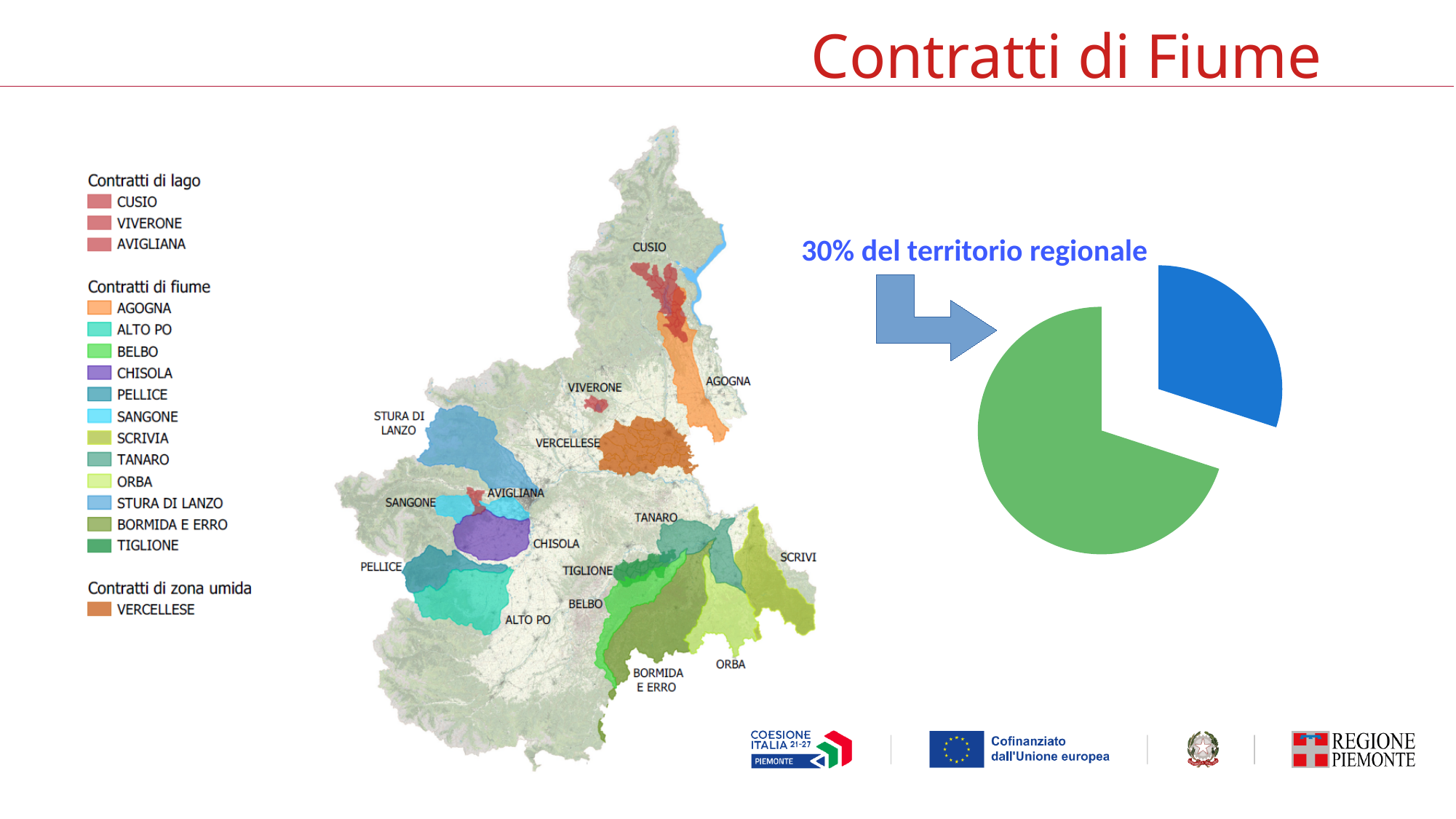
Which slice of the pie chart is pulled out (exploded) from the rest of the pie? the blue slice Is the blue slice of the pie chart greater or less than 50% of the pie? less Which colour slice is the largest in the pie chart? green What text does the arrow next to the pie chart point from? 30% del territorio regionale What share of the regional territory does the blue slice of the pie chart represent, according to the label on the slide? 30% What kind of chart is shown on the right side of the slide? pie chart Which slice of the pie chart is larger, the blue one or the green one? green How many slices does the pie chart have? 2 Is the green slice of the pie chart greater or less than 50% of the pie? greater Which colour slice is the smallest in the pie chart? blue